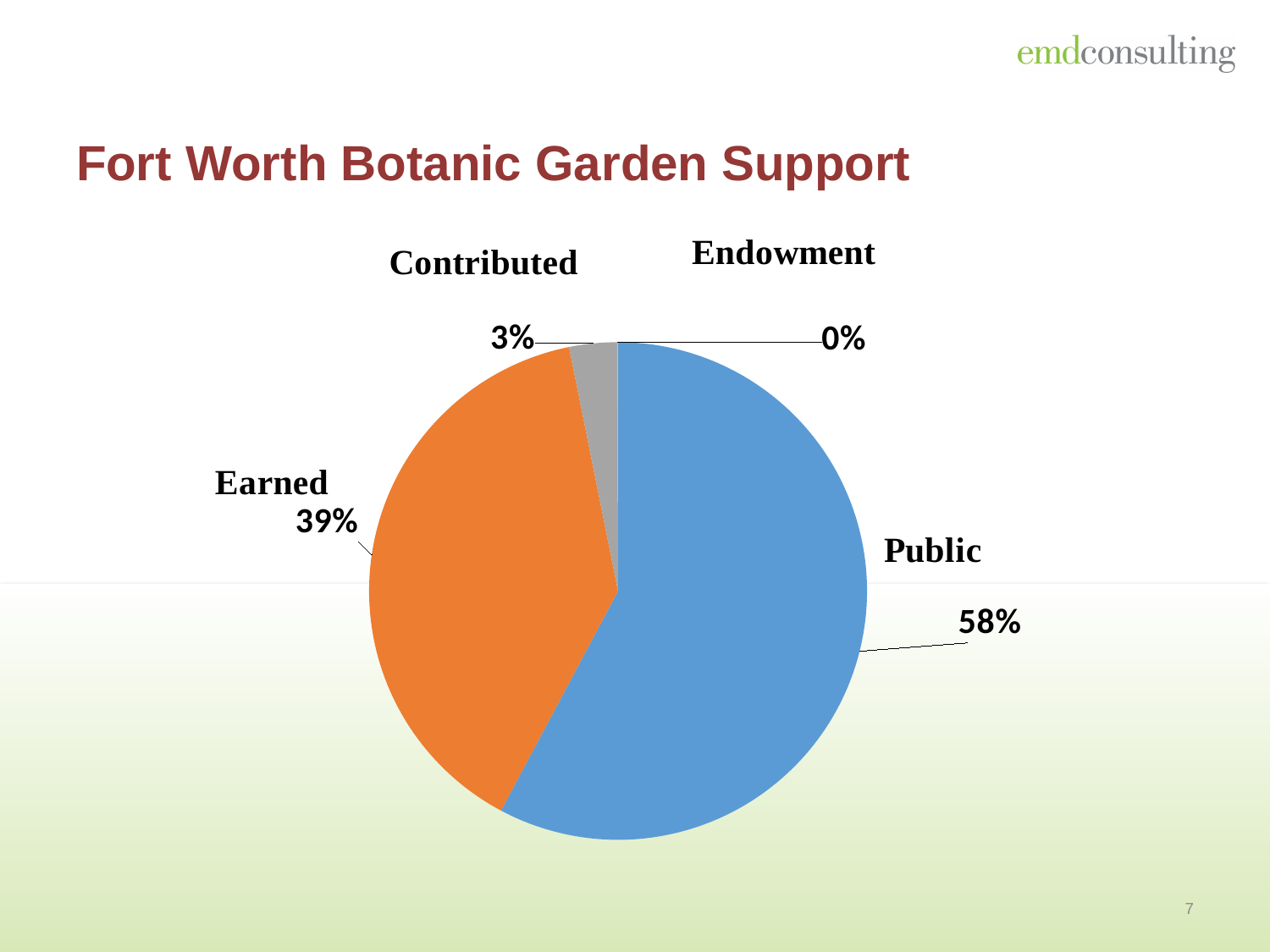
Which is larger, the Earned share or the Contributed share? Earned What is the title of the slide containing the pie chart? Fort Worth Botanic Garden Support Which source provides the largest share of support? Public How many categories are shown in the pie chart? 4 Which source provides the smallest share of support? Endowment What percentage of support is Earned? 39% What percentage of support comes from Endowment? 0% What kind of chart is shown on the slide? pie chart What is the difference in percentage points between the Earned and Contributed shares? 36 How many percentage points larger is the Public share than the Earned share? 19 What percentage of support is Contributed? 3% What share of Fort Worth Botanic Garden support comes from Public sources? 58%